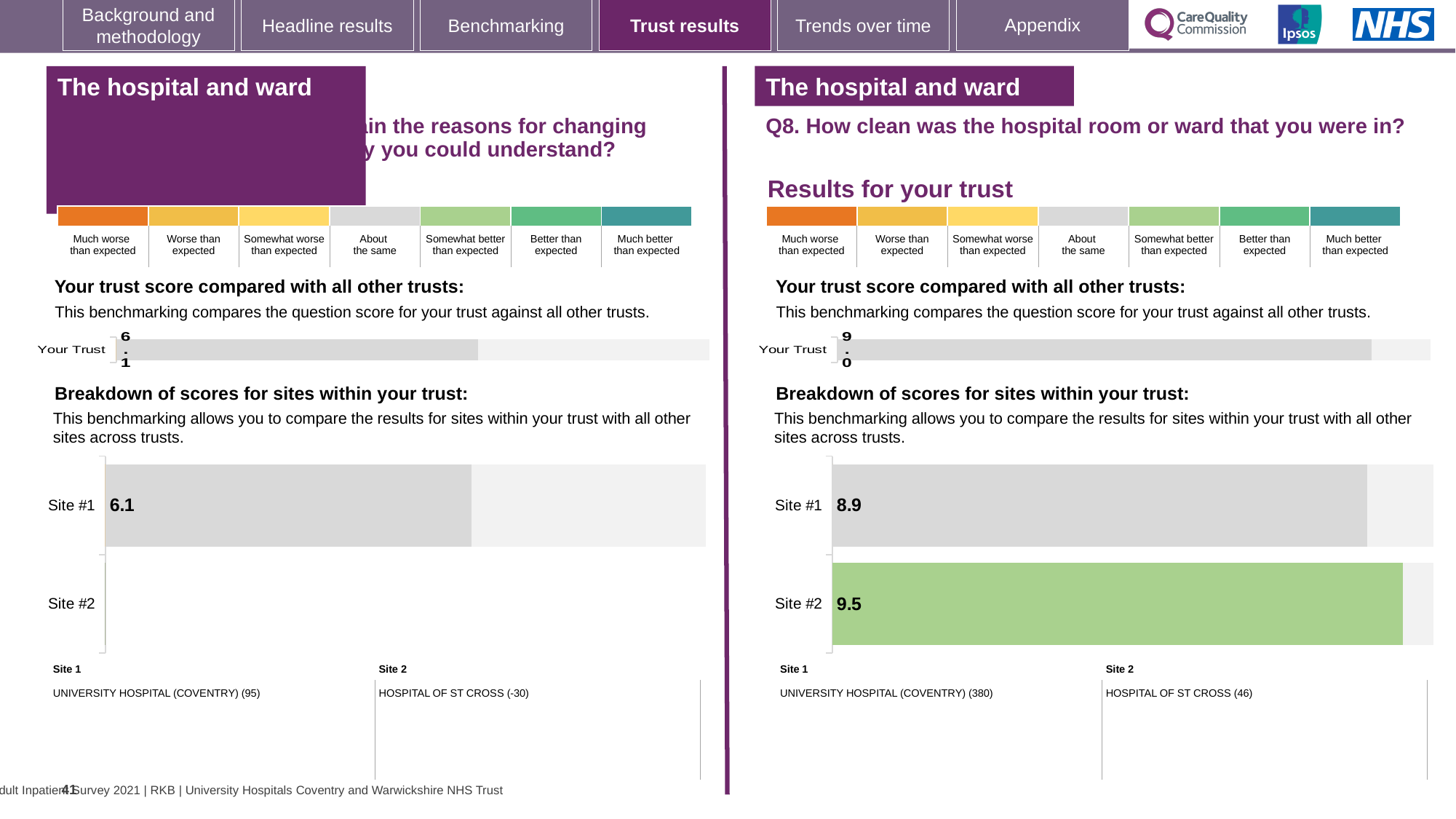
In the left-hand chart (Your trust score compared with all other trusts), what is the score for Your Trust? 6.1 In the right-hand chart for Q8 (Breakdown of scores for sites within your trust), what is the difference between the Site #2 and Site #1 scores? 0.6 In the right-hand chart for Q8 (Breakdown of scores for sites within your trust), what is the score for Site #1? 8.9 What kind of chart is used for the Breakdown of scores for sites within your trust on the right-hand side of the slide? Bar chart In the right-hand chart for Q8 (Breakdown of scores for sites within your trust), which site has the lowest score? Site #1 On the right-hand side for Q8, which is larger: the Your Trust score or the Site #1 score? Your Trust score In the right-hand chart for Q8 (Your trust score compared with all other trusts), what is the score for Your Trust? 9.0 In the right-hand chart for Q8 (Breakdown of scores for sites within your trust), what is the score for Site #2? 9.5 In the right-hand chart for Q8 (Breakdown of scores for sites within your trust), which site has the highest score? Site #2 In the right-hand chart for Q8 (Breakdown of scores for sites within your trust), how many sites are plotted? 2 In the right-hand chart for Q8 (Breakdown of scores for sites within your trust), what colour is the bar for Site #2? Green In the left-hand chart (Breakdown of scores for sites within your trust), what is the score for Site #1? 6.1